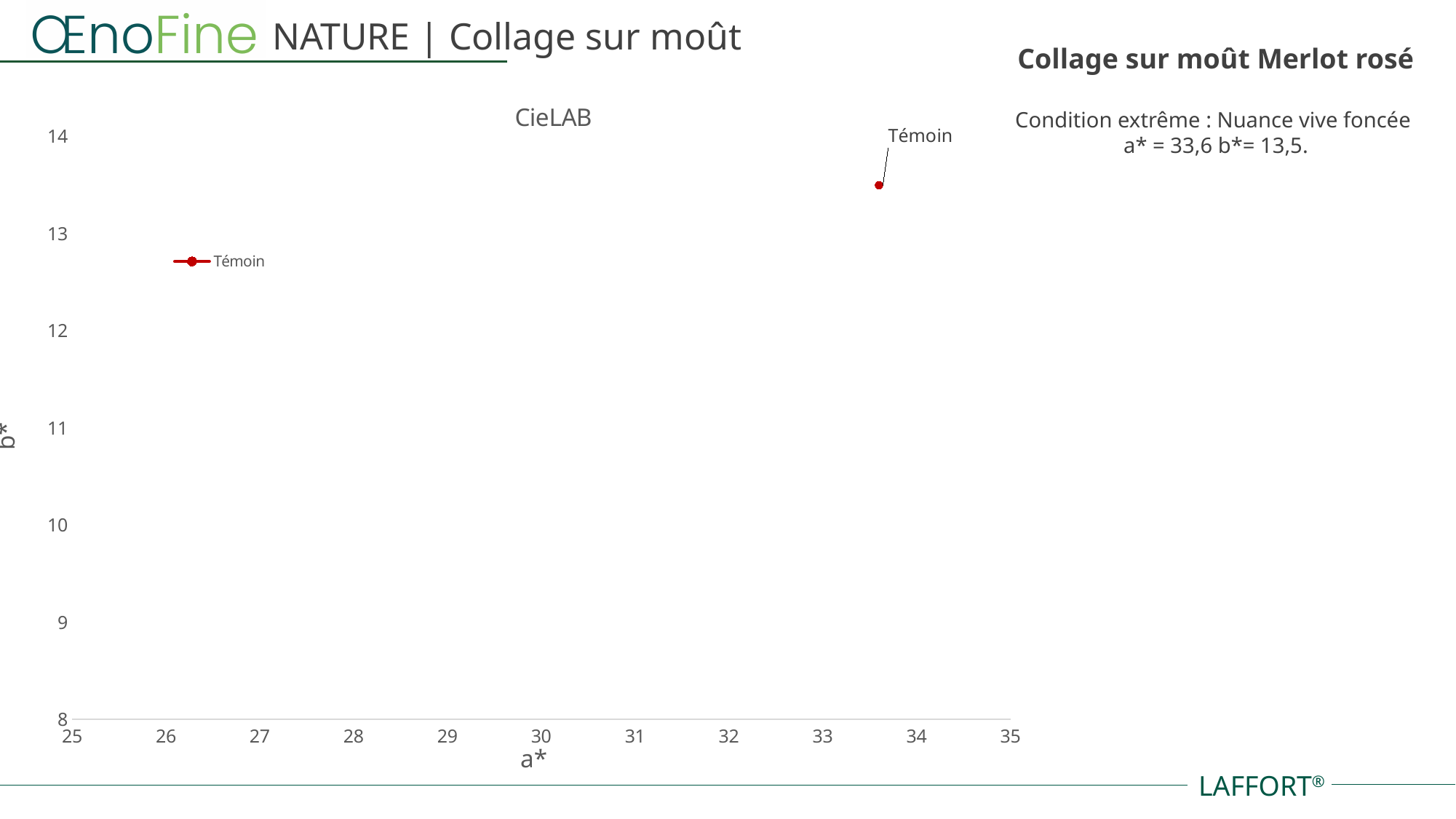
What is the name of the series plotted on the chart? Témoin Is the a* value of the Témoin point labelled in the upper right of the chart greater or less than 30? greater What is the lowest tick value shown on the y axis of the chart? 8 What is the highest tick value shown on the x axis of the chart? 35 Is the b* value of the Témoin point labelled in the upper right of the chart greater or less than 13? greater What kind of chart is shown on the slide? scatter chart What label is on the x axis of the chart? a* What is the title of the chart? CieLAB Is the b* value of the Témoin point labelled in the upper right of the chart greater or less than 14? less